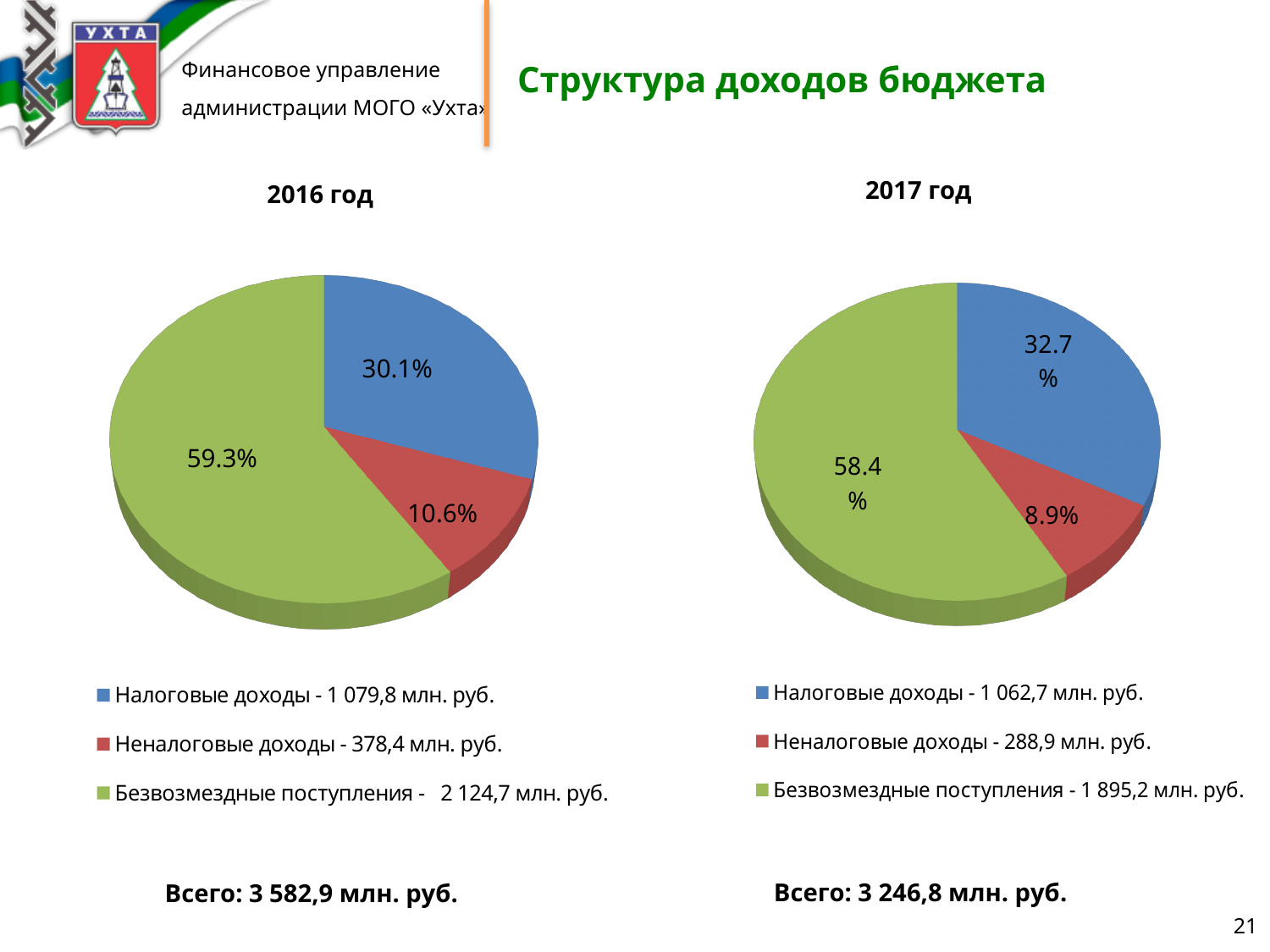
In the 2016 год chart, what share does Неналоговые доходы have? 10.6% In the 2016 год chart, what share does Безвозмездные поступления have? 59.3% In the 2017 год chart, what colour is the slice for Безвозмездные поступления? green In the 2017 год chart, which is larger: the share of Налоговые доходы or the share of Неналоговые доходы? Налоговые доходы In the 2017 год chart, which category has the largest slice? Безвозмездные поступления What type of chart is used for the 2016 год chart? pie chart In the 2016 год chart, which category has the smallest slice? Неналоговые доходы In the 2017 год chart, what share does Налоговые доходы have? 32.7% How many slices does the 2017 год pie chart have? 3 In the 2016 год chart, what is the difference in percentage points between Безвозмездные поступления and Налоговые доходы? 29.2